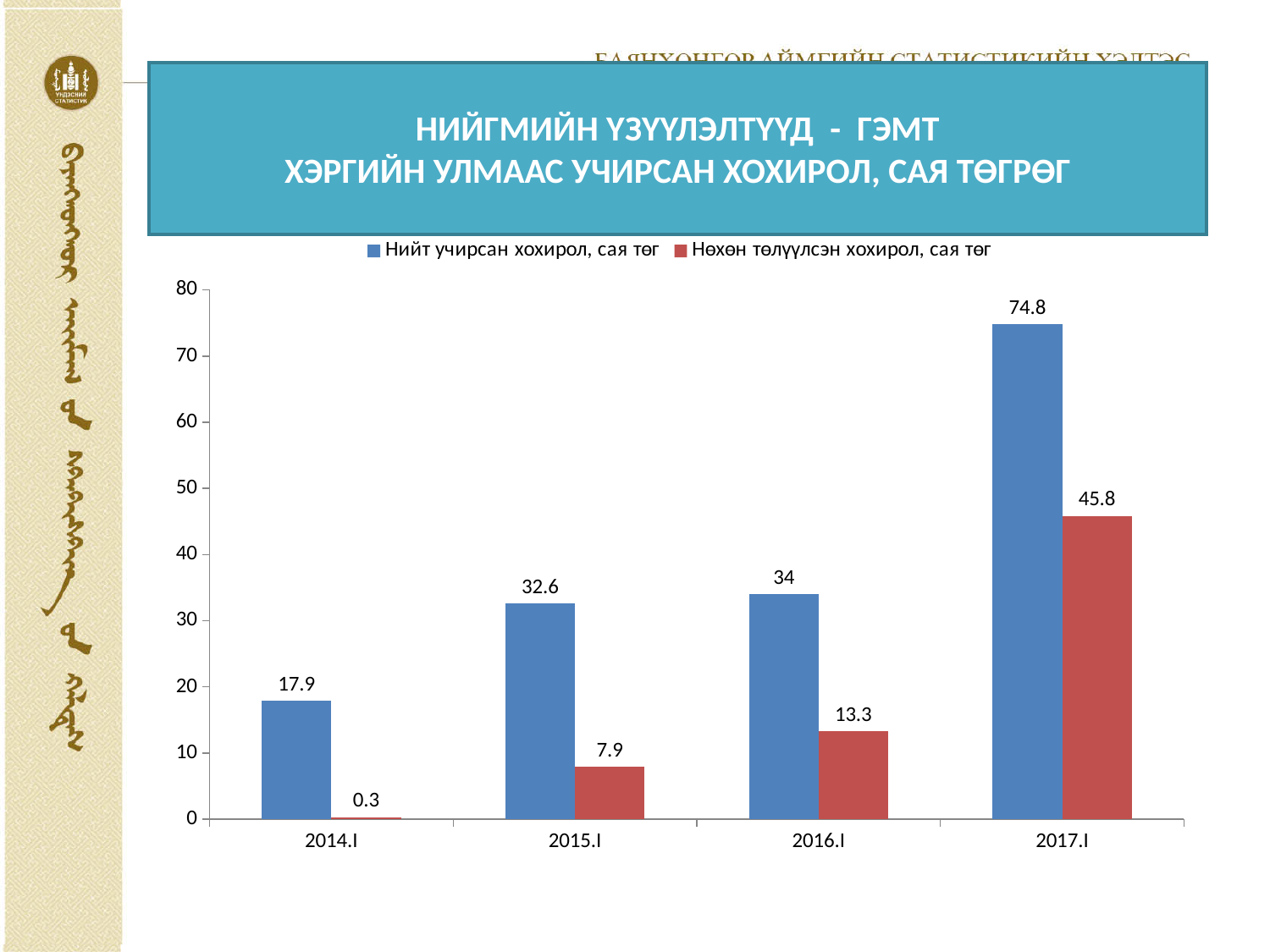
Which period has the highest value for 'Нийт учирсан хохирол, сая төг'? 2017.I How many periods are shown on the x axis? 4 What is the value of 'Нөхөн төлүүлсэн хохирол, сая төг' for 2015.I? 7.9 Which period has the lowest value for 'Нөхөн төлүүлсэн хохирол, сая төг'? 2014.I Is the value of 'Нийт учирсан хохирол, сая төг' for 2017.I greater or less than 70? greater How many series does the legend list? 2 Does 'Нийт учирсан хохирол, сая төг' rise or fall from 2014.I to 2017.I? rise What is the difference between 'Нийт учирсан хохирол, сая төг' and 'Нөхөн төлүүлсэн хохирол, сая төг' in 2016.I? 20.7 What is the value of 'Нийт учирсан хохирол, сая төг' for 2017.I? 74.8 What kind of chart is shown on the slide? bar chart Which is larger: 'Нийт учирсан хохирол, сая төг' in 2015.I or 'Нөхөн төлүүлсэн хохирол, сая төг' in 2017.I? Нөхөн төлүүлсэн хохирол, сая төг in 2017.I What is the value of 'Нөхөн төлүүлсэн хохирол, сая төг' for 2014.I? 0.3